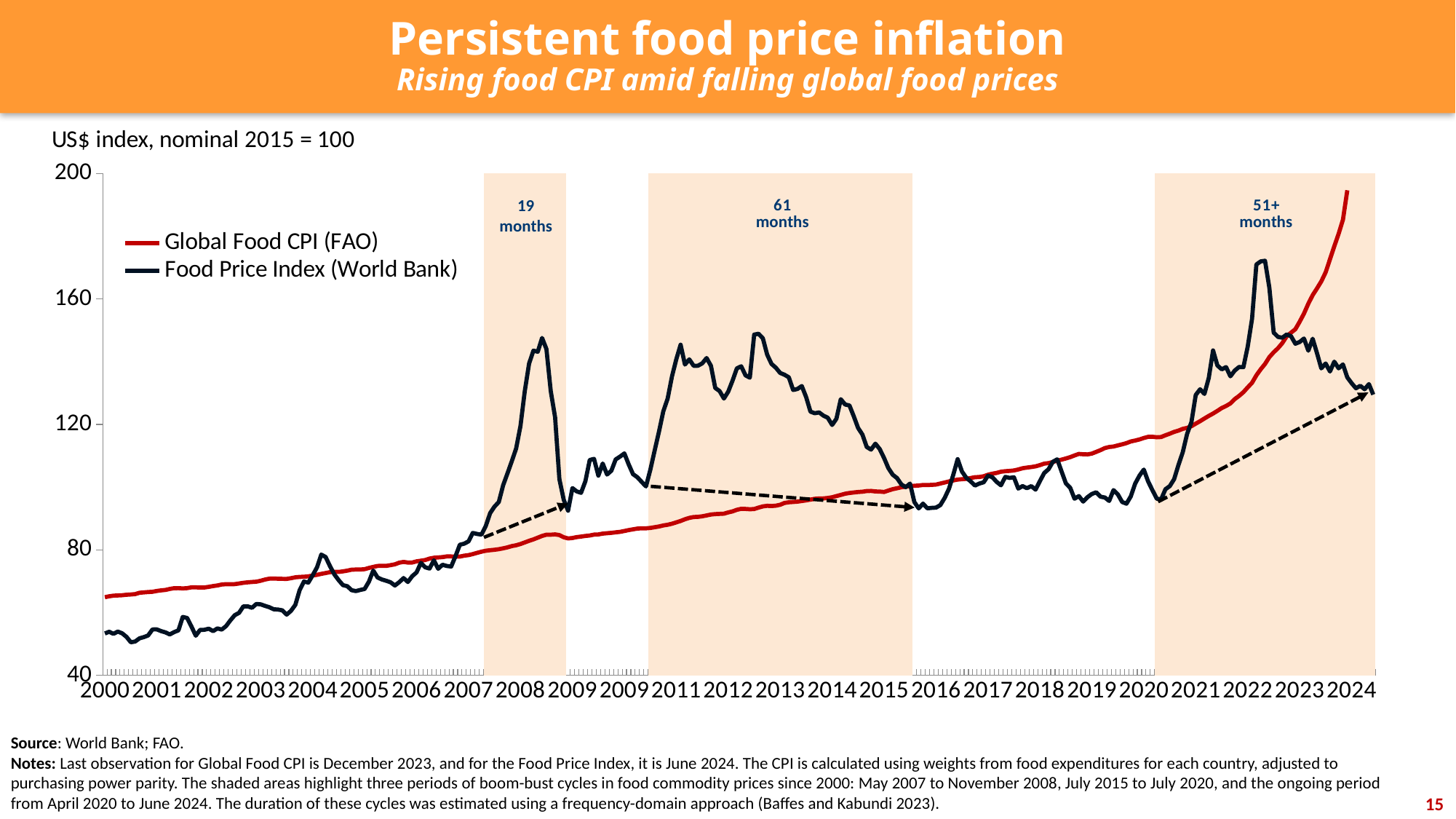
Is the value of the Food Price Index (World Bank) in 2000 greater or less than 80? less Is the value of the Global Food CPI (FAO) in 2000 greater or less than 80? less Does the Global Food CPI (FAO) series generally rise or fall from 2000 to the end of the chart? rise Which two series are listed in the legend? Global Food CPI (FAO) and Food Price Index (World Bank) What duration label is shown in the first shaded period (around 2007-2008)? 19 months Is the 2008 peak of the Food Price Index (World Bank) greater or less than 120? greater In 2000, which series has the higher value, Global Food CPI (FAO) or Food Price Index (World Bank)? Global Food CPI (FAO) Which series reaches the highest value anywhere on the chart? Global Food CPI (FAO) What kind of chart is shown on the slide? line chart How many series does the legend list? 2